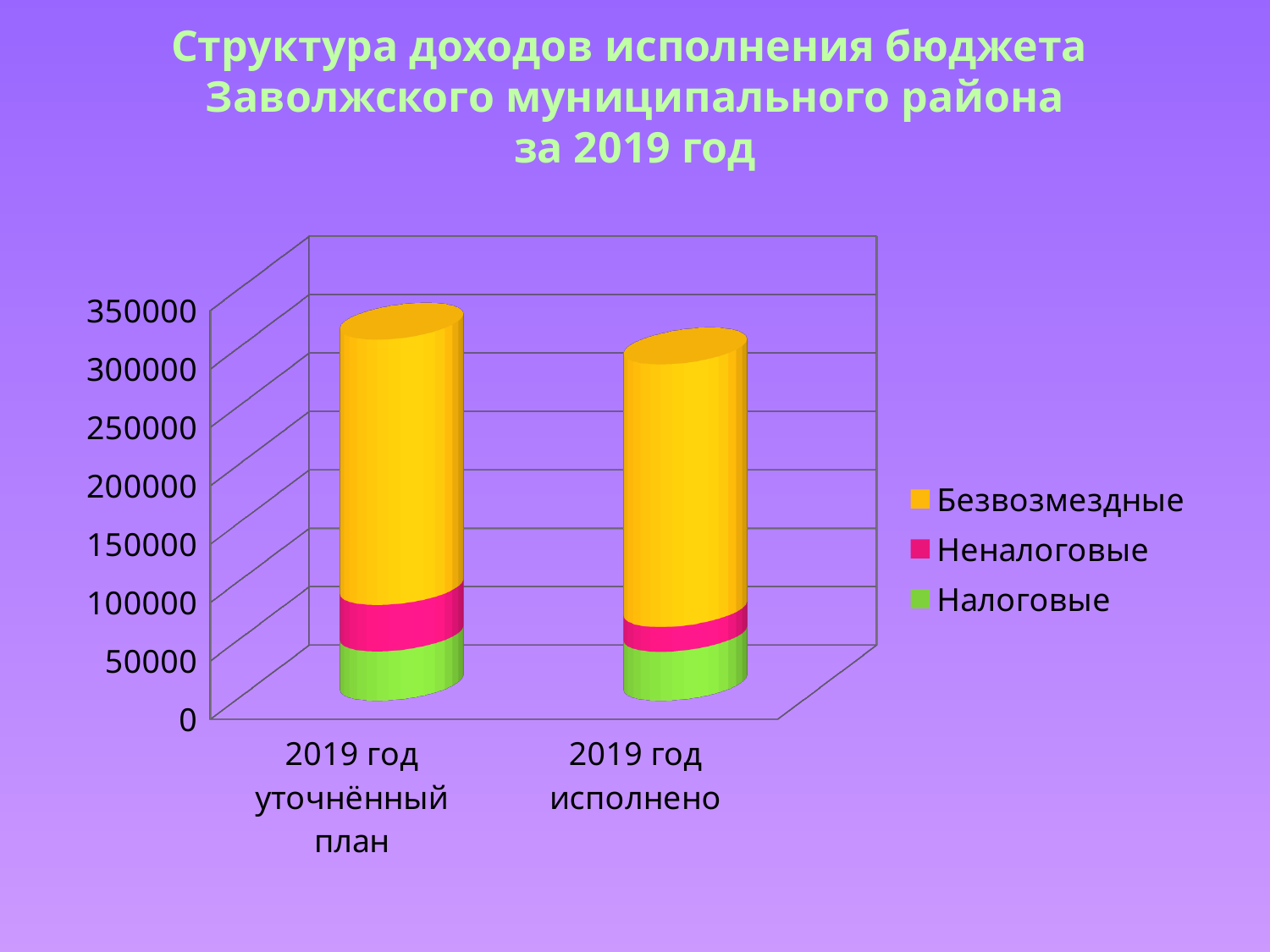
Is the Налоговые value for "2019 год уточнённый план" greater or less than 100000? less How many categories are shown on the x axis of the chart? 2 Is the total value of the "2019 год исполнено" bar greater or less than 250000? greater How many series does the legend list? 3 Which series is shown in yellow in the chart? Безвозмездные Is the total value of the "2019 год уточнённый план" bar greater or less than 250000? greater Does the total bar height rise or fall from "2019 год уточнённый план" to "2019 год исполнено"? fall What is the title of the chart on the slide? Структура доходов исполнения бюджета Заволжского муниципального района за 2019 год Which category has the taller stacked bar, "2019 год уточнённый план" or "2019 год исполнено"? 2019 год уточнённый план Which category has the larger Неналоговые segment, "2019 год уточнённый план" or "2019 год исполнено"? 2019 год уточнённый план What kind of chart is shown on the slide? bar chart